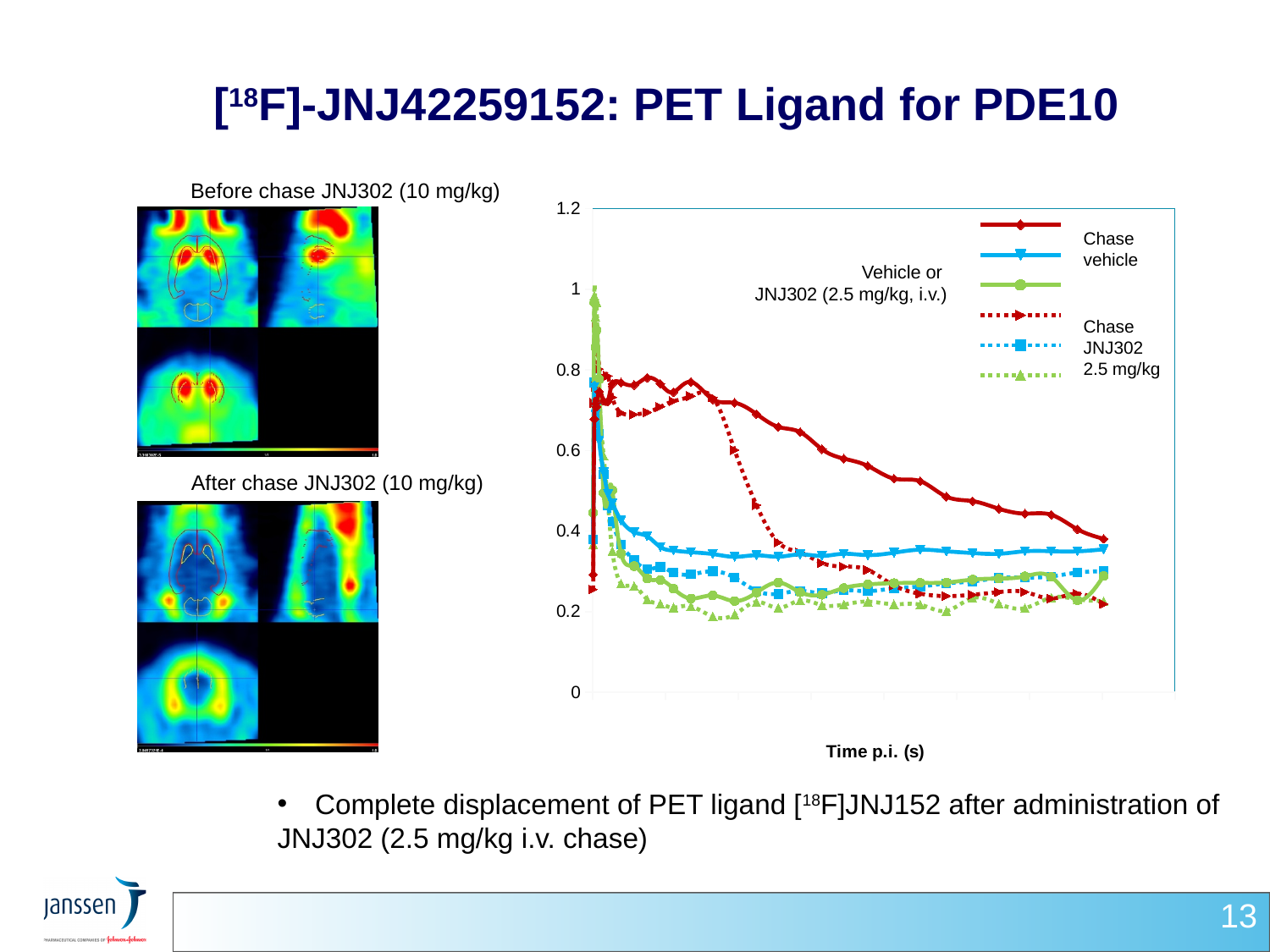
In the middle of the time range, which is higher, the solid red 'Chase vehicle' line or the solid blue 'Chase vehicle' line? Solid red line What is the highest value shown on the y axis of the chart? 1.2 What kind of chart is shown on the slide? Line chart Which line stays highest across most of the time range: the solid red line, the solid blue line, or the solid green line? Solid red line Is the solid red 'Chase vehicle' line in the middle of the time range greater or less than 0.4? greater Are the green lines in the second half of the time range greater or less than 0.4? less Does the solid red 'Chase vehicle' line rise or fall along the x axis after its initial peak? Fall Is the plateau of the solid blue 'Chase vehicle' line greater or less than 0.6? less What is the label of the x axis of the chart? Time p.i. (s) Which line style is used for the 'Chase JNJ302 2.5 mg/kg' series in the legend, solid or dotted? Dotted How many series does the chart's legend list? 6